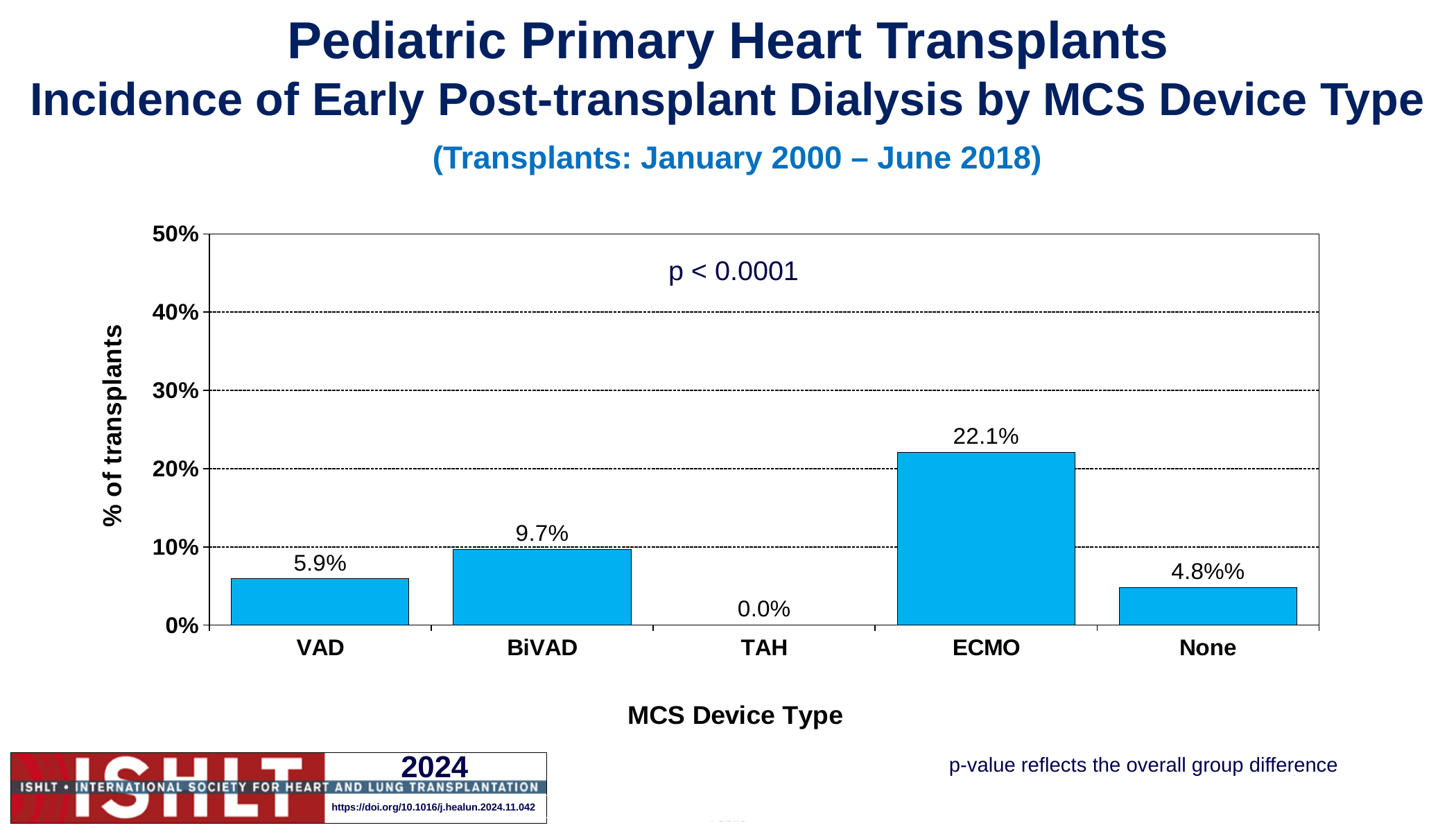
What is the difference between the values for BiVAD and VAD? 3.8% How many MCS device type categories are shown on the x axis? 5 What is the difference between the values for ECMO and BiVAD? 12.4% What is the value for BiVAD? 9.7% What is the value for TAH? 0.0% Is the value for ECMO greater or less than 20%? greater Which MCS device type has the lowest incidence of early post-transplant dialysis? TAH Which is larger, the value for VAD or the value for None? VAD Which MCS device type has the highest incidence of early post-transplant dialysis? ECMO What is the value for VAD? 5.9% What kind of chart is shown on the slide? bar chart What is the value for ECMO? 22.1%